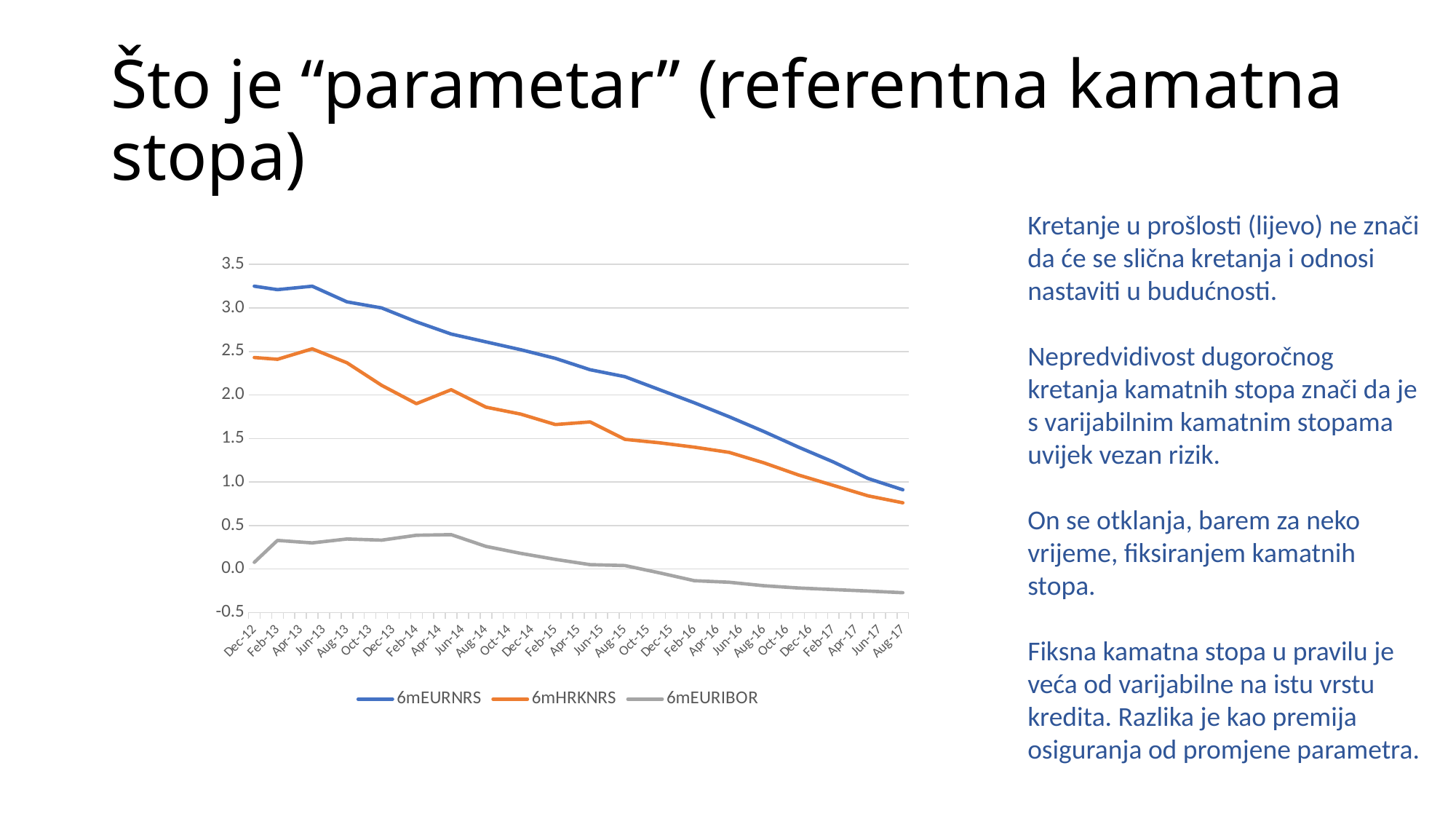
Is the value of 6mEURIBOR at Jun-14 greater or less than 0.5? less What colour is the 6mEURIBOR line? grey Does the 6mEURNRS line rise or fall from Dec-12 to Aug-17? fall Is the value of 6mEURNRS at Dec-12 greater or less than 3.0? greater Which series is plotted highest across the whole chart? 6mEURNRS Which series is plotted lowest across the whole chart? 6mEURIBOR How many series does the chart legend list? 3 At Dec-12, which is larger: 6mEURNRS or 6mHRKNRS? 6mEURNRS What is the last date label on the x axis? Aug-17 Is the value of 6mHRKNRS at Aug-17 greater or less than 1.0? less What kind of chart is shown on the slide? line chart